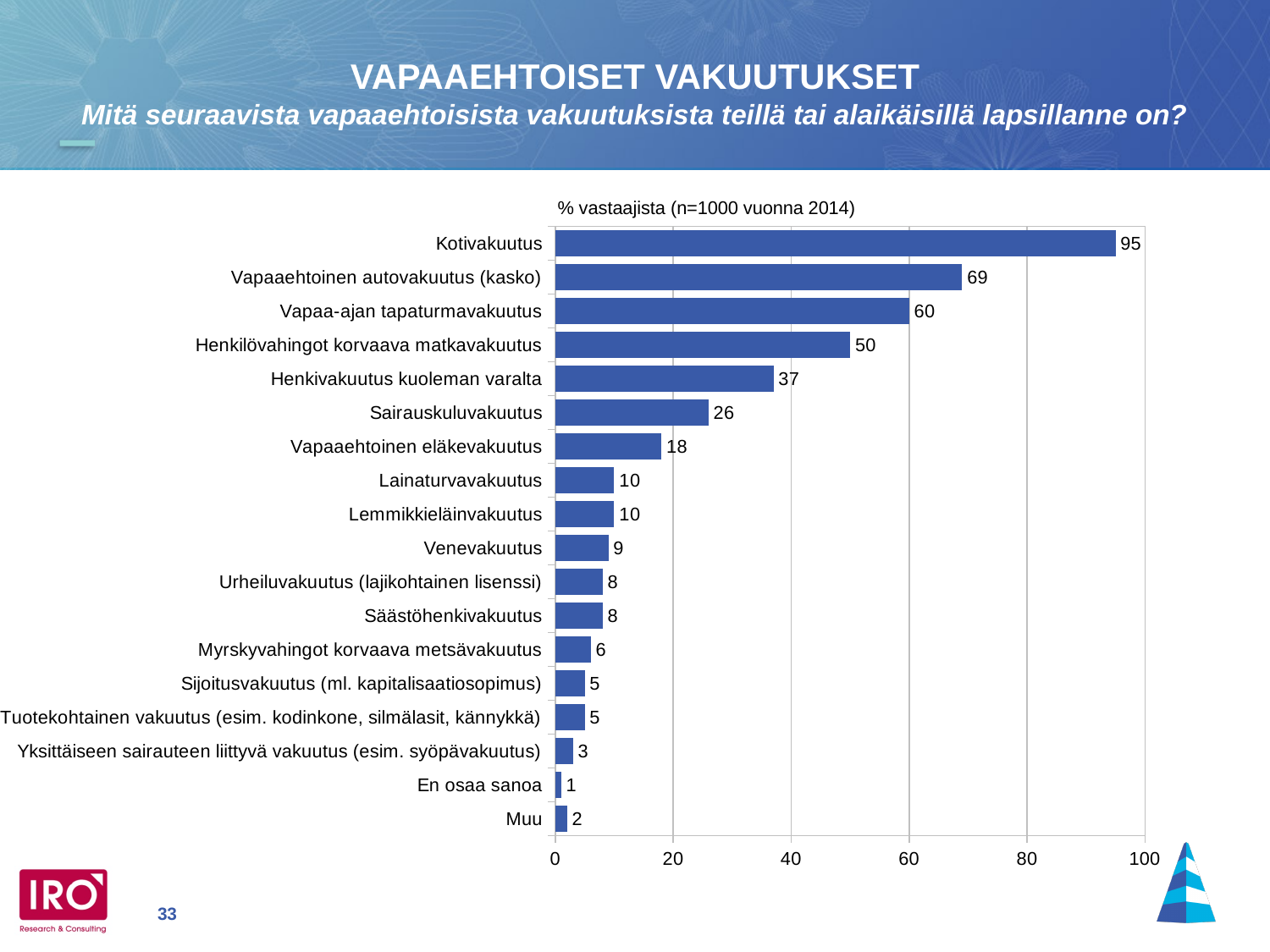
Which category has the highest value? Kotivakuutus Which category has the lowest value? En osaa sanoa What is the value for Kotivakuutus? 95 What kind of chart is shown on the slide? Bar chart What is the value for Henkivakuutus kuoleman varalta? 37 What is the difference between the values for Kotivakuutus and Vapaaehtoinen autovakuutus (kasko)? 26 What is the value for Muu? 2 How many categories are shown in the chart? 18 Which is larger, the value for Vapaaehtoinen eläkevakuutus or the value for Lainaturvavakuutus? Vapaaehtoinen eläkevakuutus What is the value for Sairauskuluvakuutus? 26 What is the text shown above the chart describing the measure? % vastaajista (n=1000 vuonna 2014) What is the difference between the values for Vapaa-ajan tapaturmavakuutus and Henkilövahingot korvaava matkavakuutus? 10